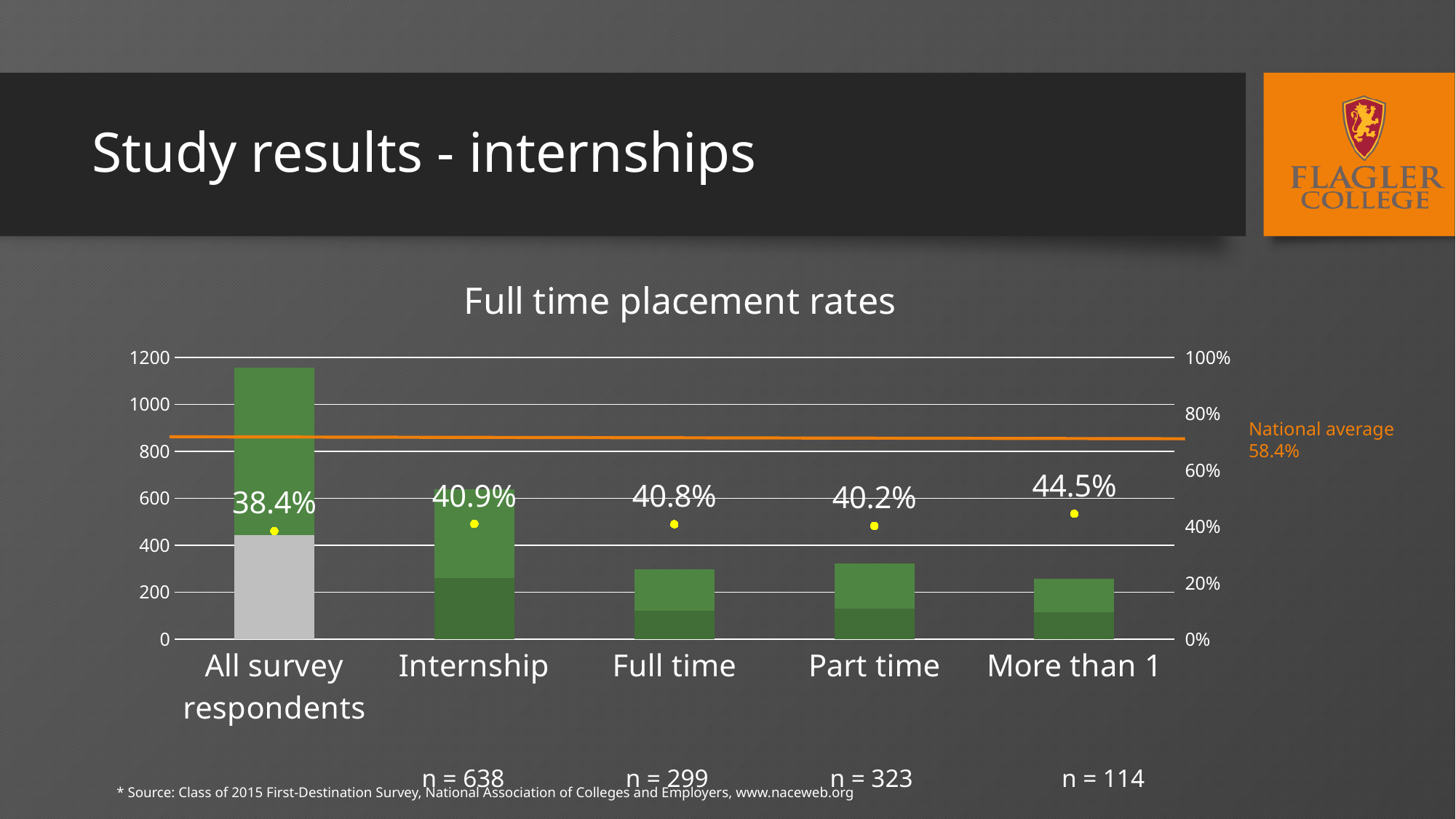
Which has a higher full time placement rate, Part time or Full time? Full time Is the total bar height for All survey respondents greater or less than 1000 on the left axis? greater What is the full time placement rate shown for the More than 1 category? 44.5% Is the total bar height for Internship greater or less than 800 on the left axis? less Which category has the highest full time placement rate? More than 1 What is the full time placement rate shown for the Internship category? 40.9% How many categories are shown on the x axis of the chart? 5 What national average value is marked by the orange line on the chart? 58.4% What is the full time placement rate shown for All survey respondents? 38.4% What kind of chart is used to show the full time placement rates? Bar chart Which category has the lowest full time placement rate? All survey respondents What is the difference in percentage points between the placement rate for More than 1 and for All survey respondents? 6.1